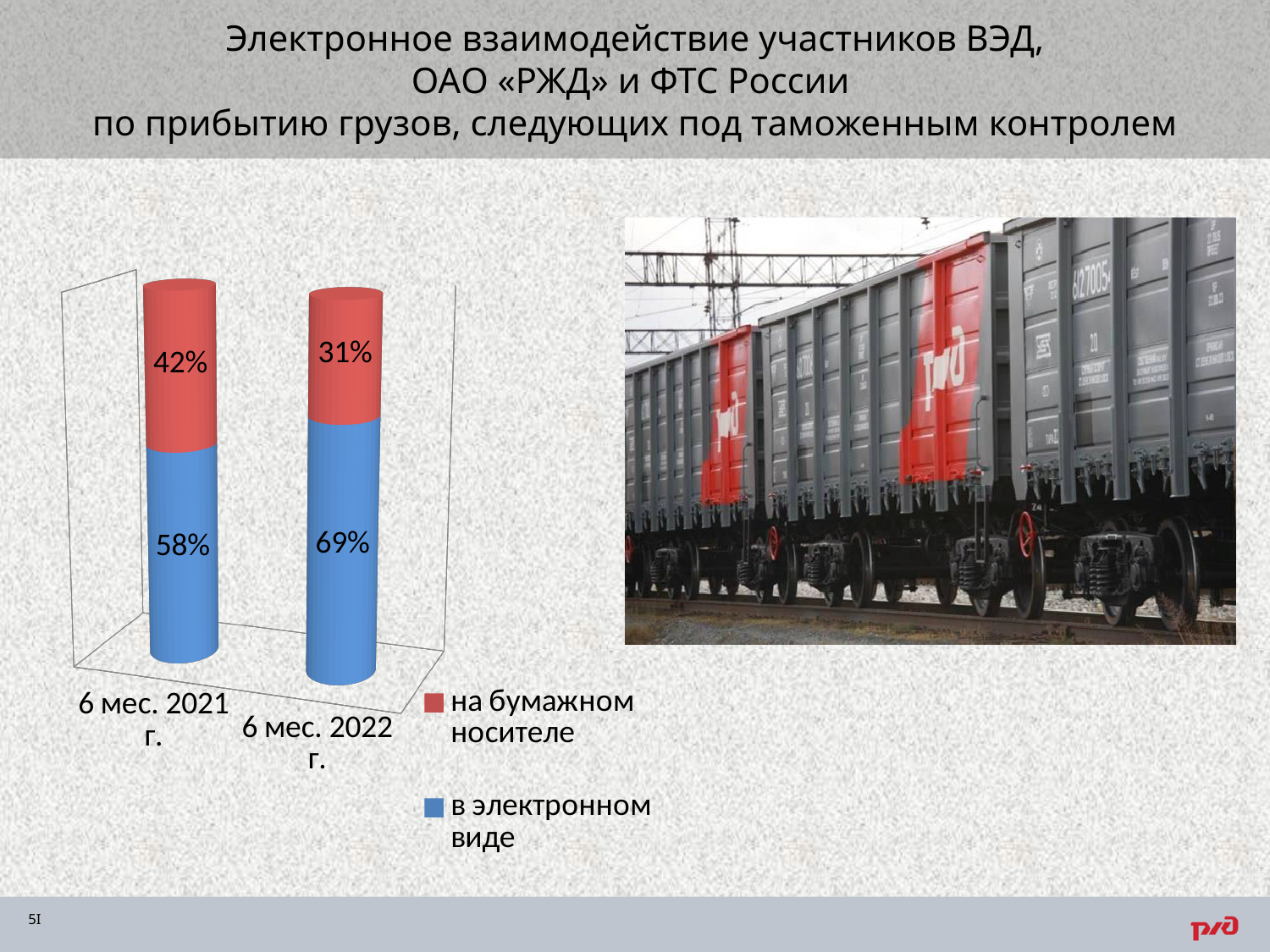
What share of documents was on paper (на бумажном носителе) for 6 мес. 2021 г.? 42% What share of documents was on paper (на бумажном носителе) for 6 мес. 2022 г.? 31% Which colour represents 'на бумажном носителе' in the chart legend? Red In which period was the share of paper documents (на бумажном носителе) lowest? 6 мес. 2022 г. By how many percentage points did the share of electronic documents (в электронном виде) change from 6 мес. 2021 г. to 6 мес. 2022 г.? 11 percentage points In which period was the share of electronic documents (в электронном виде) highest? 6 мес. 2022 г. What share of documents was in electronic form (в электронном виде) for 6 мес. 2021 г.? 58% Which is larger for 6 мес. 2021 г.: the share on paper or the share in electronic form? в электронном виде (58%) What kind of chart is shown on the slide? Stacked bar chart What share of documents was in electronic form (в электронном виде) for 6 мес. 2022 г.? 69% How many series does the chart legend list? 2 How many periods (categories) are shown on the chart? 2